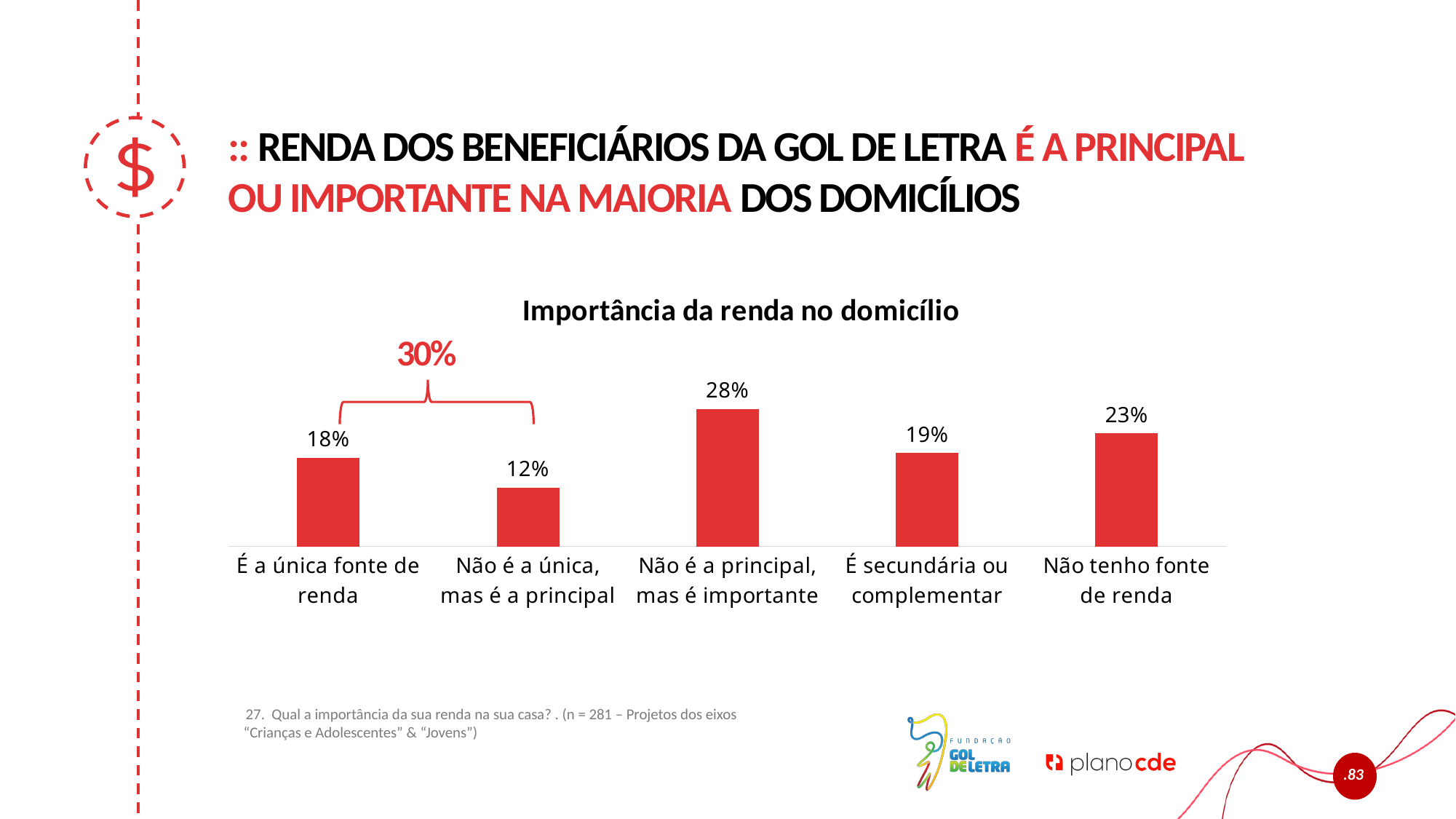
What is the combined value indicated by the bracket over the first two bars? 30% What is the value for "É a única fonte de renda"? 18% Which is larger: "Não tenho fonte de renda" or "É secundária ou complementar"? Não tenho fonte de renda How many categories are shown in the chart? 5 What is the title of the chart? Importância da renda no domicílio What kind of chart is shown? Bar chart Which category has the highest value? Não é a principal, mas é importante What is the difference between "Não é a principal, mas é importante" and "Não é a única, mas é a principal"? 16% What is the value for "É secundária ou complementar"? 19% What is the value for "Não é a principal, mas é importante"? 28% What is the value for "Não tenho fonte de renda"? 23% Which category has the lowest value? Não é a única, mas é a principal